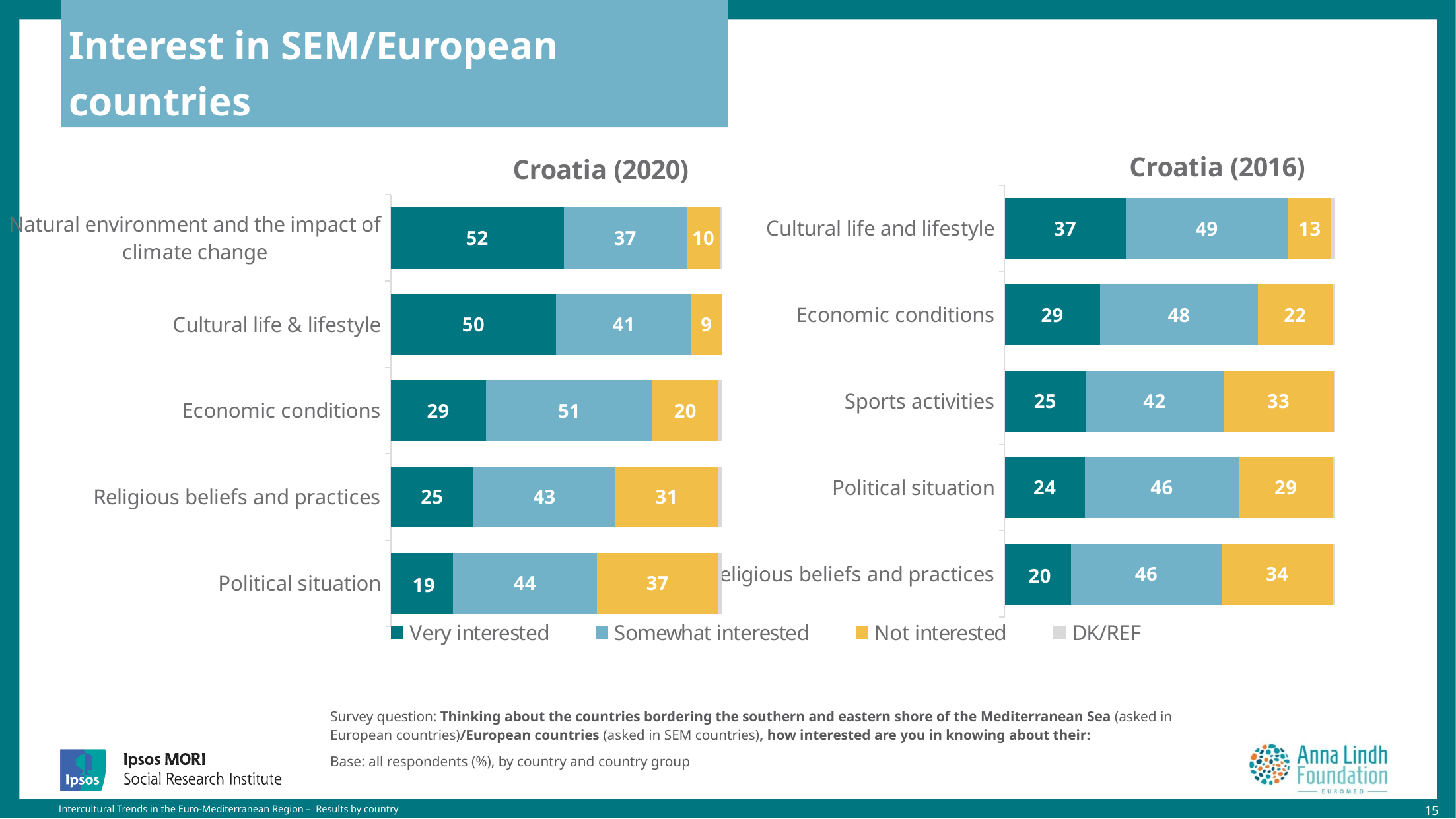
What type of chart is the Croatia (2020) chart? Stacked bar chart In the Croatia (2020) chart, what percentage is 'Very interested' in Natural environment and the impact of climate change? 52 In the Croatia (2020) chart, is the 'Somewhat interested' value larger for Economic conditions or for Religious beliefs and practices? Economic conditions In the Croatia (2020) chart, what is the 'Not interested' value for Political situation? 37 In the Croatia (2016) chart, what is the difference between the 'Not interested' values for Religious beliefs and practices and Cultural life and lifestyle? 21 In the Croatia (2016) chart, what is the 'Not interested' value for Sports activities? 33 How many categories are shown in the Croatia (2016) chart? 5 How many series does the legend list? 4 In the Croatia (2020) chart, which category has the highest 'Very interested' value? Natural environment and the impact of climate change In the Croatia (2016) chart, which category has the lowest 'Very interested' value? Religious beliefs and practices In the Croatia (2016) chart, what is the 'Somewhat interested' value for Cultural life and lifestyle? 49 In the Croatia (2020) chart, what is the difference between the 'Very interested' values for Cultural life & lifestyle and Political situation? 31